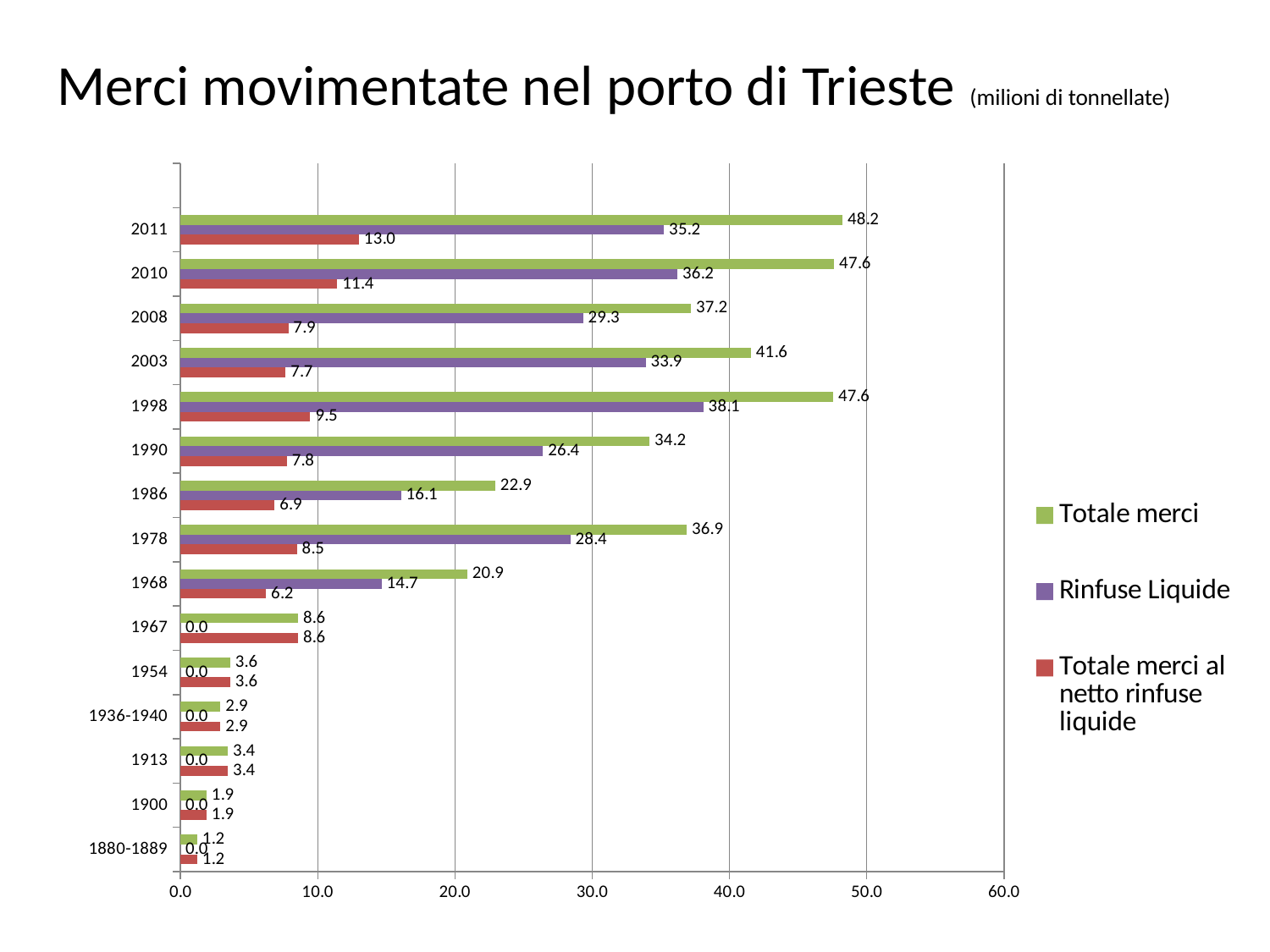
What is the value of Totale merci for 2011? 48.2 Which category has the highest value for Rinfuse Liquide? 1998 How many categories are shown on the vertical axis? 15 Is the value of Totale merci for 1978 greater or less than 30.0? greater What is the difference between Totale merci for 2011 and Totale merci for 2010? 0.6 What is the value of Rinfuse Liquide for 1998? 38.1 Which category has the lowest value for Totale merci? 1880-1889 What kind of chart is shown on the slide? bar chart How many series does the legend list? 3 What is the value of Totale merci al netto rinfuse liquide for 2010? 11.4 Which is larger: Rinfuse Liquide for 2003 or Rinfuse Liquide for 2008? 2003 What is the value of Rinfuse Liquide for 1967? 0.0